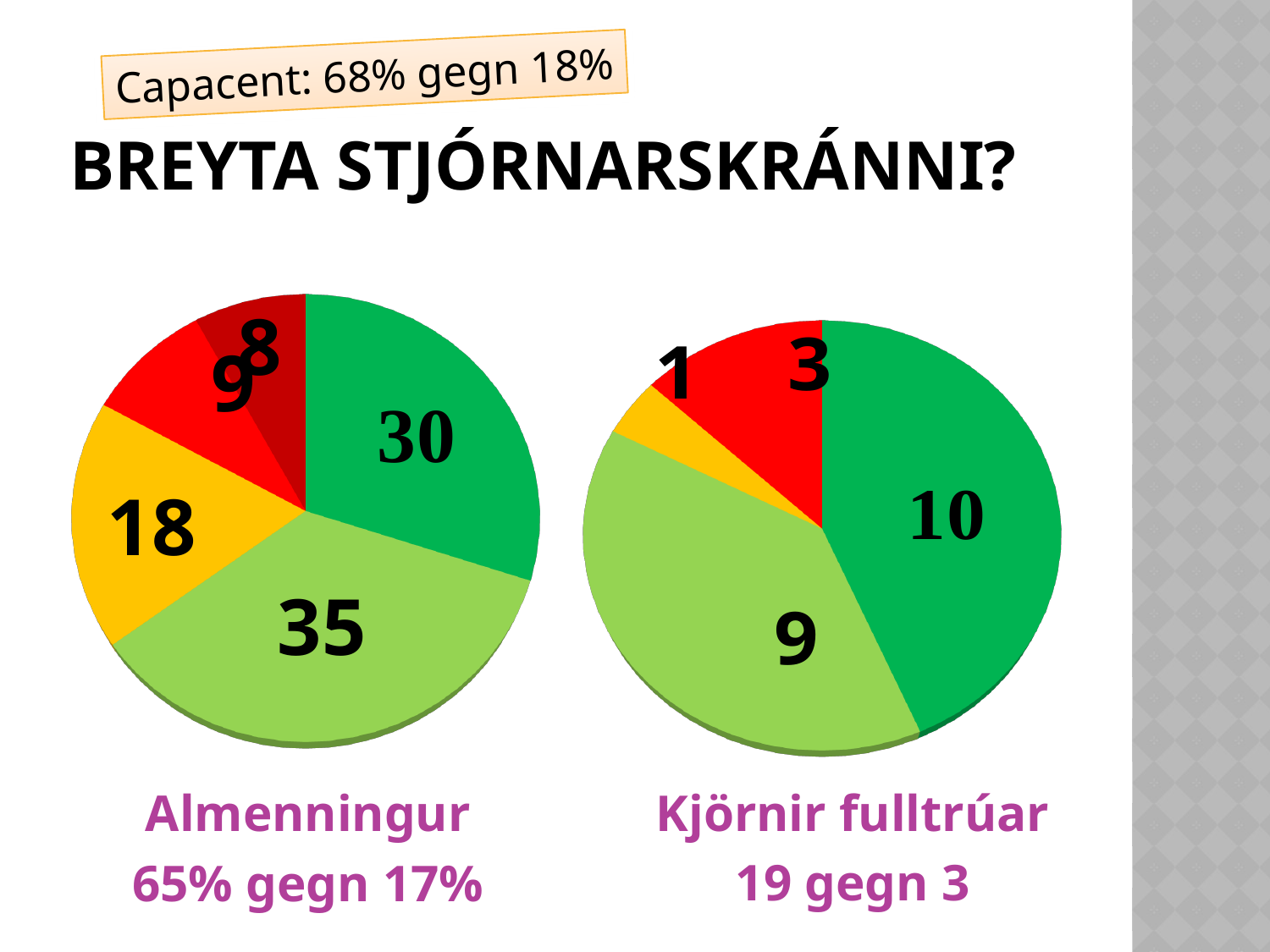
In the Almenningur pie chart, which slice has the smallest value? The dark red slice (8) In the Kjörnir fulltrúar pie chart, what is the value of the dark green slice? 10 How many pie charts are on the slide? 2 In the Kjörnir fulltrúar pie chart, what is the total of all slices? 23 In the Almenningur pie chart, which slice has the largest value? The light green slice (35) In the Almenningur pie chart, what is the value of the yellow slice? 18 What kind of charts are shown on the slide? Pie charts In the Kjörnir fulltrúar pie chart, which slice has the smallest value? The yellow slice (1) In the Almenningur pie chart, what is the value of the light green slice? 35 In the Almenningur pie chart, what is the difference between the light green slice (35) and the dark green slice (30)? 5 In the Almenningur pie chart, how many slices are there? 5 In the Kjörnir fulltrúar pie chart, is the red slice (3) larger or smaller than the light green slice (9)? Smaller